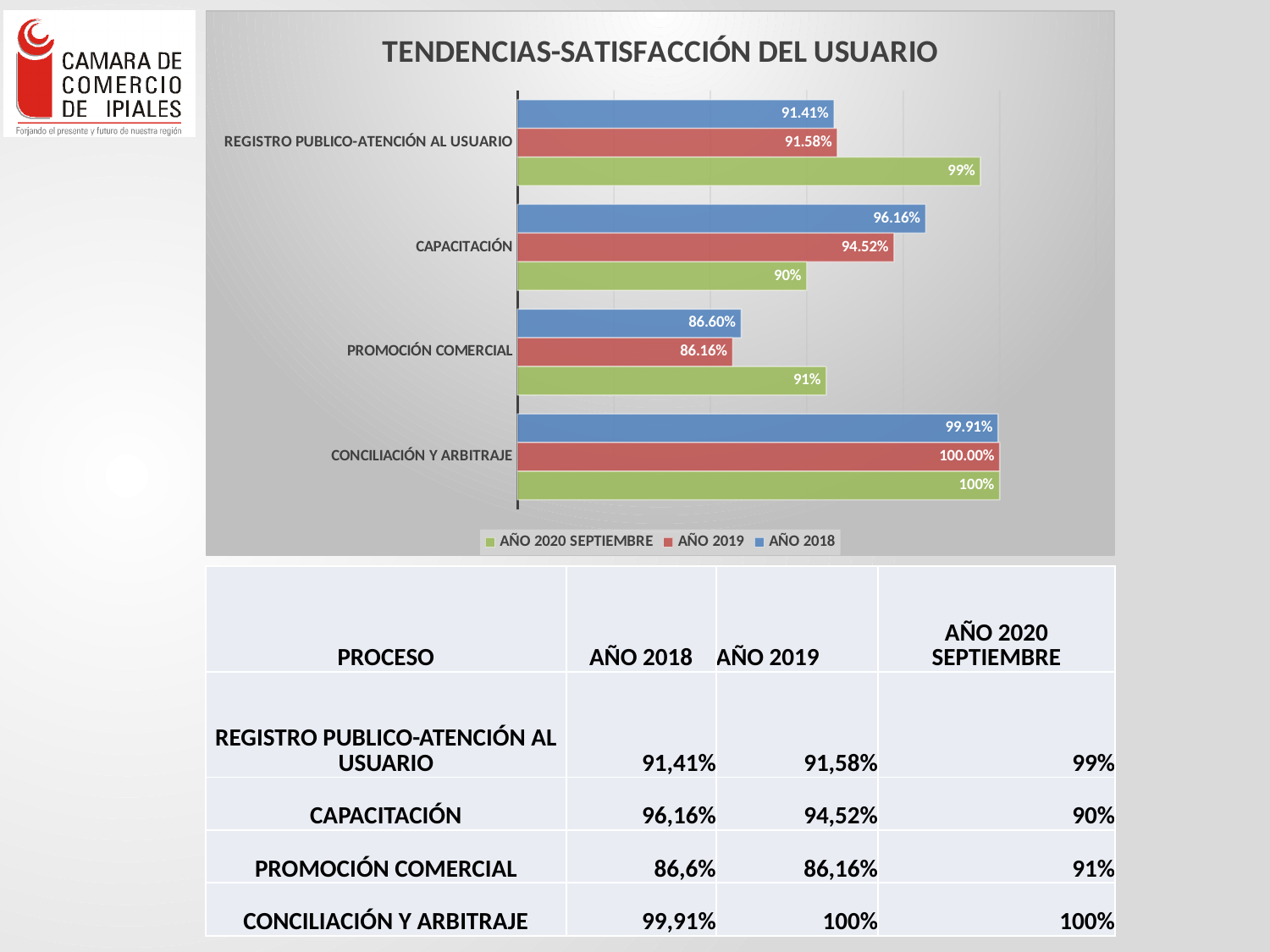
How many categories are shown on the chart? 4 What is the value for AÑO 2019 in the CAPACITACIÓN category? 94.52% What is the title of the chart? TENDENCIAS-SATISFACCIÓN DEL USUARIO Which category has the lowest value for the AÑO 2019 series? PROMOCIÓN COMERCIAL What is the difference between the AÑO 2020 SEPTIEMBRE and AÑO 2018 values for REGISTRO PUBLICO-ATENCIÓN AL USUARIO? 7.59% Which category has the highest value for the AÑO 2018 series? CONCILIACIÓN Y ARBITRAJE What is the value for AÑO 2020 SEPTIEMBRE in the PROMOCIÓN COMERCIAL category? 91% What is the value for AÑO 2018 in the CONCILIACIÓN Y ARBITRAJE category? 99.91% What kind of chart is shown on the slide? Bar chart In the CAPACITACIÓN category, which is larger: the AÑO 2018 value or the AÑO 2020 SEPTIEMBRE value? AÑO 2018 What is the value for AÑO 2018 in the REGISTRO PUBLICO-ATENCIÓN AL USUARIO category? 91.41% How many series does the legend list? 3